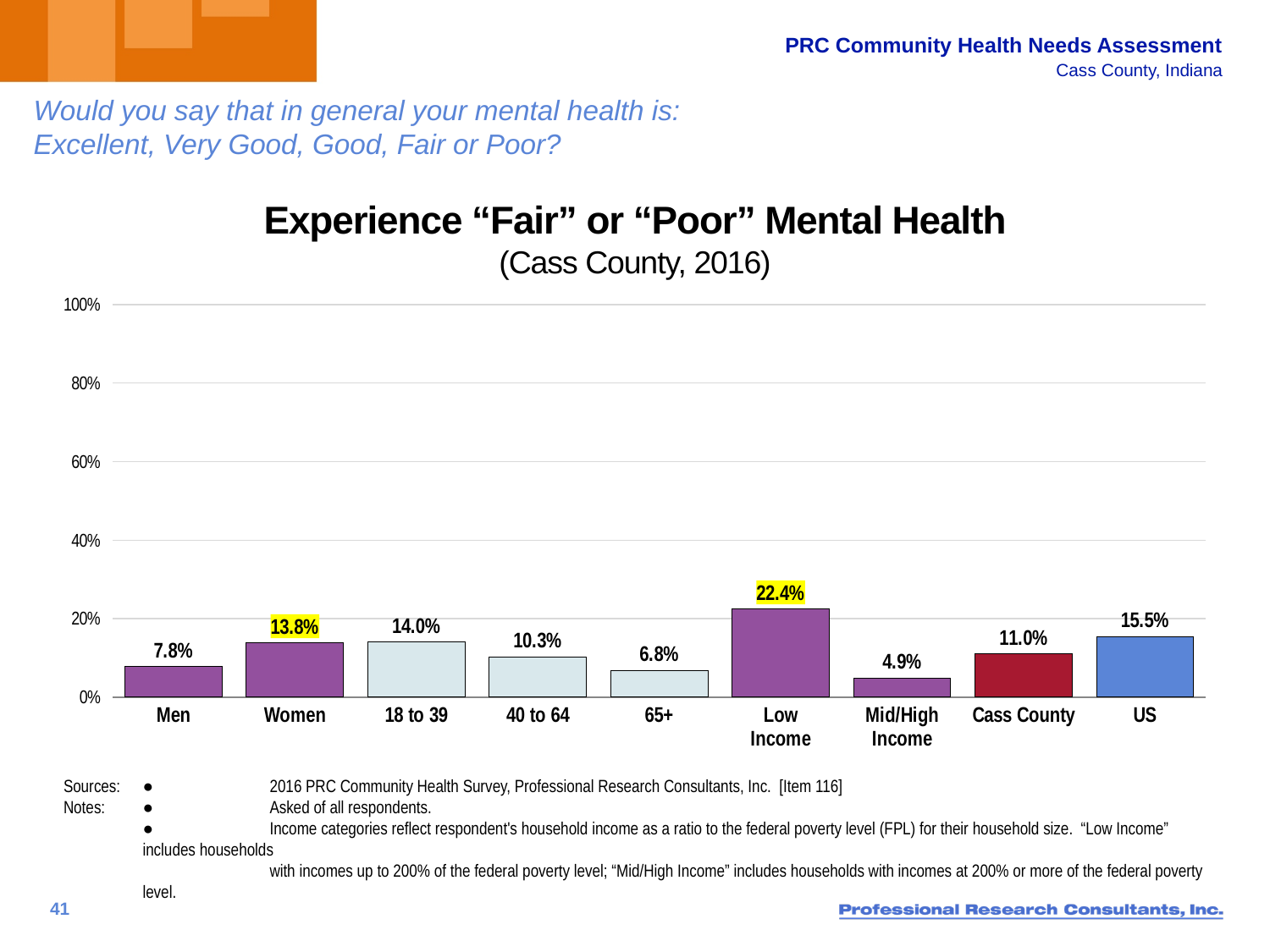
Is the value for Low Income greater or less than 20%? greater What is the value for the US? 15.5% How many categories are shown on the x axis? 9 What is the value for Low Income? 22.4% What percentage of women experience fair or poor mental health? 13.8% Which is larger, the value for Men or the value for Women? Women Which category has the highest value? Low Income What is the value for Cass County? 11.0% What is the difference between the Low Income and Mid/High Income values? 17.5% Which category has the lowest value? Mid/High Income What kind of chart is this? Bar chart What is the difference between the US and Cass County values? 4.5%